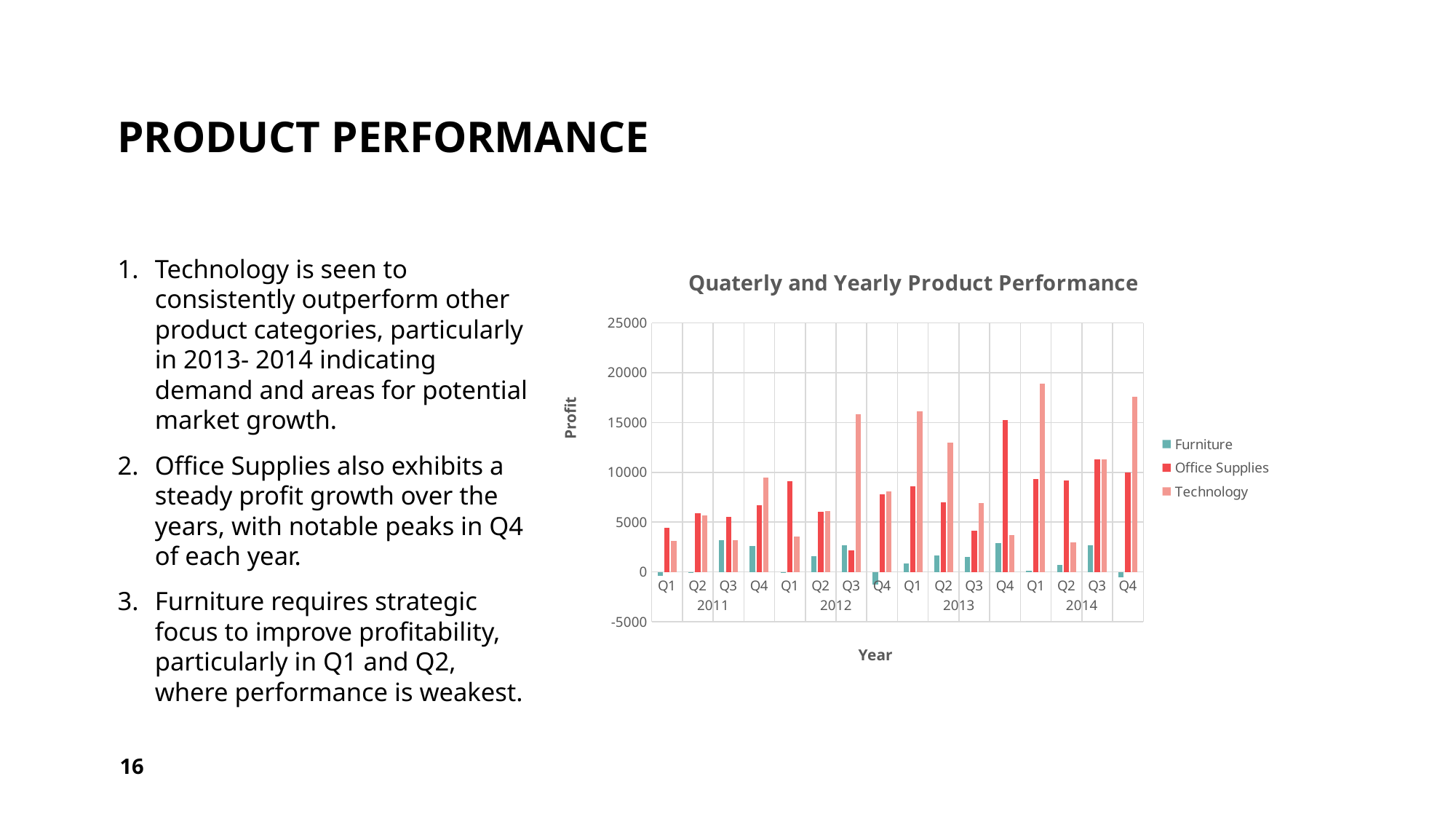
Is the Office Supplies profit in Q1 2012 greater or less than 10000? less What is the label on the y axis of the chart? Profit In which quarter does Technology reach its highest profit? Q1 2014 What is the title of the chart? Quaterly and Yearly Product Performance In Q4 2013, which has the higher profit: Office Supplies or Technology? Office Supplies In which quarter does Office Supplies reach its highest profit? Q4 2013 Is the Technology profit in Q1 2014 greater or less than 15000? greater How many series does the legend list? 3 Is the Technology profit in Q4 2014 greater or less than 15000? greater How many quarters are plotted along the x axis? 16 In Q3 2012, which has the higher profit: Technology or Office Supplies? Technology What kind of chart is shown on the slide? bar chart